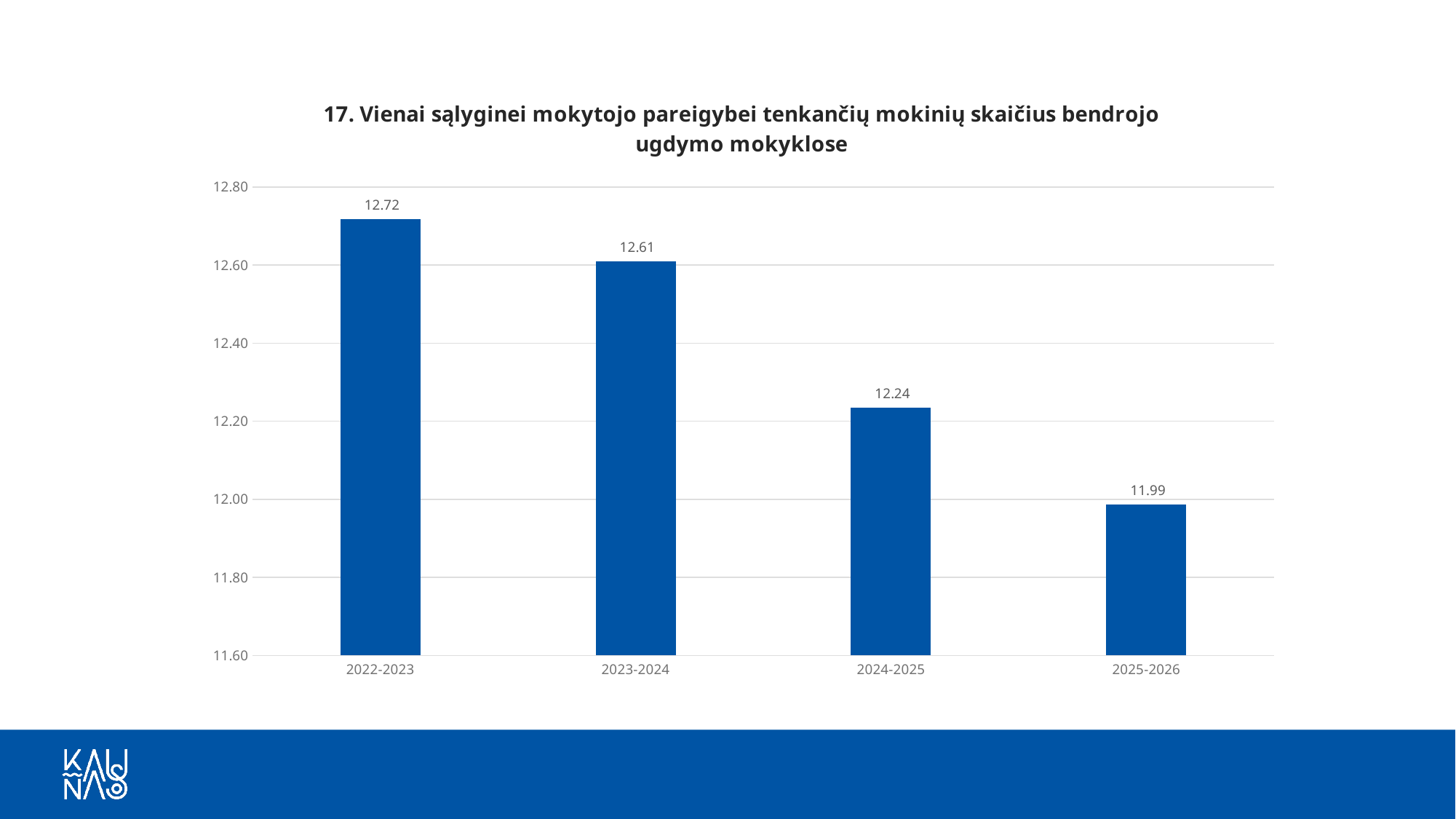
How many school years are shown on the x axis? 4 What is the difference between the values for 2023-2024 and 2024-2025? 0.37 Which school year has the lowest value? 2025-2026 Is the value for 2025-2026 greater or less than 12.00? less What is the value for 2025-2026? 11.99 What kind of chart is shown on the slide? bar chart What is the difference between the values for 2022-2023 and 2025-2026? 0.73 Which is larger, the value for 2023-2024 or the value for 2024-2025? 2023-2024 What is the value for 2022-2023? 12.72 Which school year has the highest value? 2022-2023 What is the value for 2024-2025? 12.24 What is the value for 2023-2024? 12.61